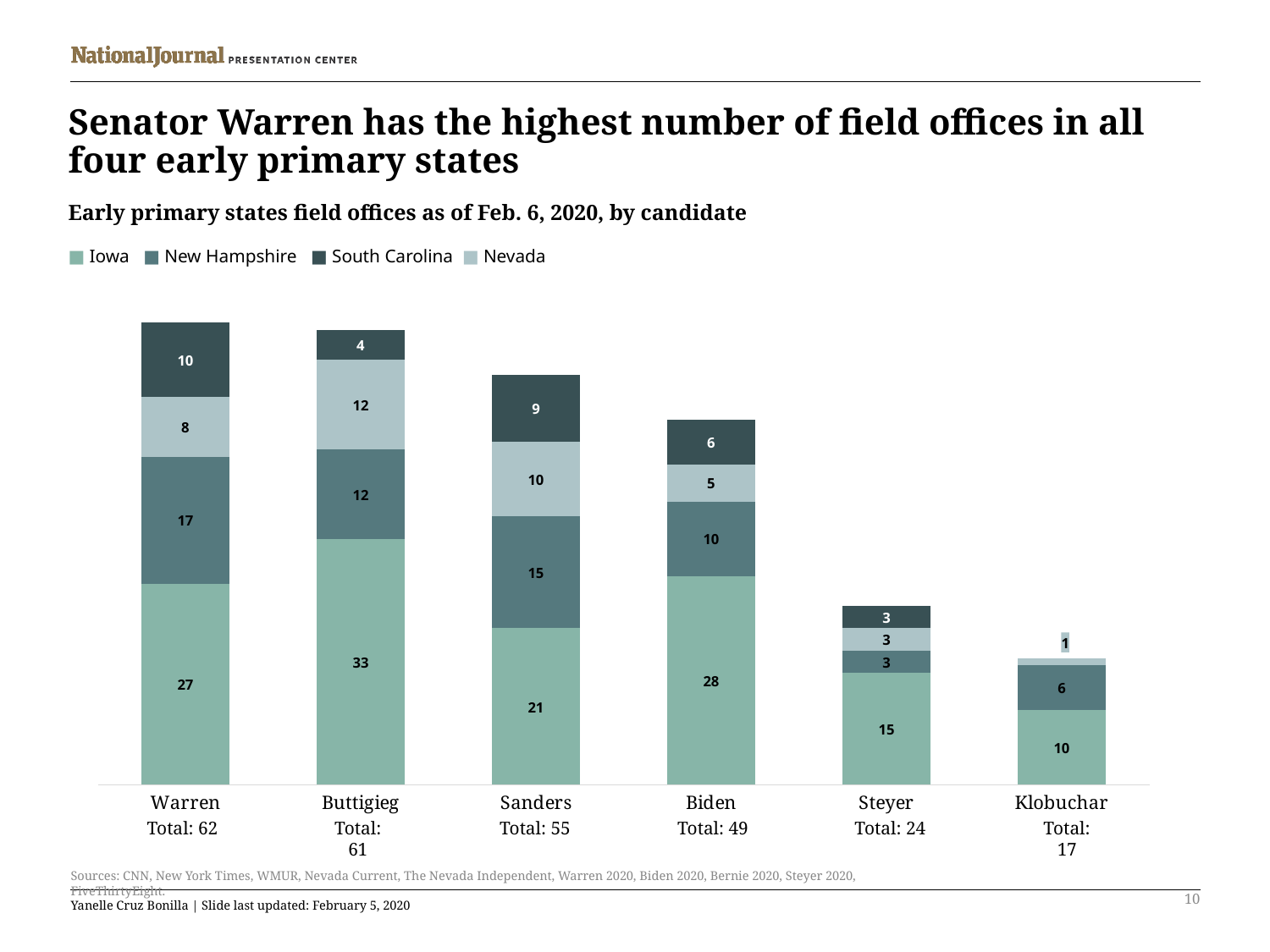
Who has more Iowa field offices, Biden or Warren? Biden How many series does the legend list? 4 How many Nevada field offices does Biden have? 5 How many candidates are shown in the chart? 6 Which candidate has the lowest total number of field offices? Klobuchar What is the total number of field offices for Sanders? 55 What kind of chart is shown on the slide? Stacked bar chart Which candidate has the highest total number of field offices? Warren How many Iowa field offices does Buttigieg have? 33 How many New Hampshire field offices does Warren have? 17 What is the difference between Warren's and Buttigieg's total field offices? 1 How many South Carolina field offices does Sanders have? 9